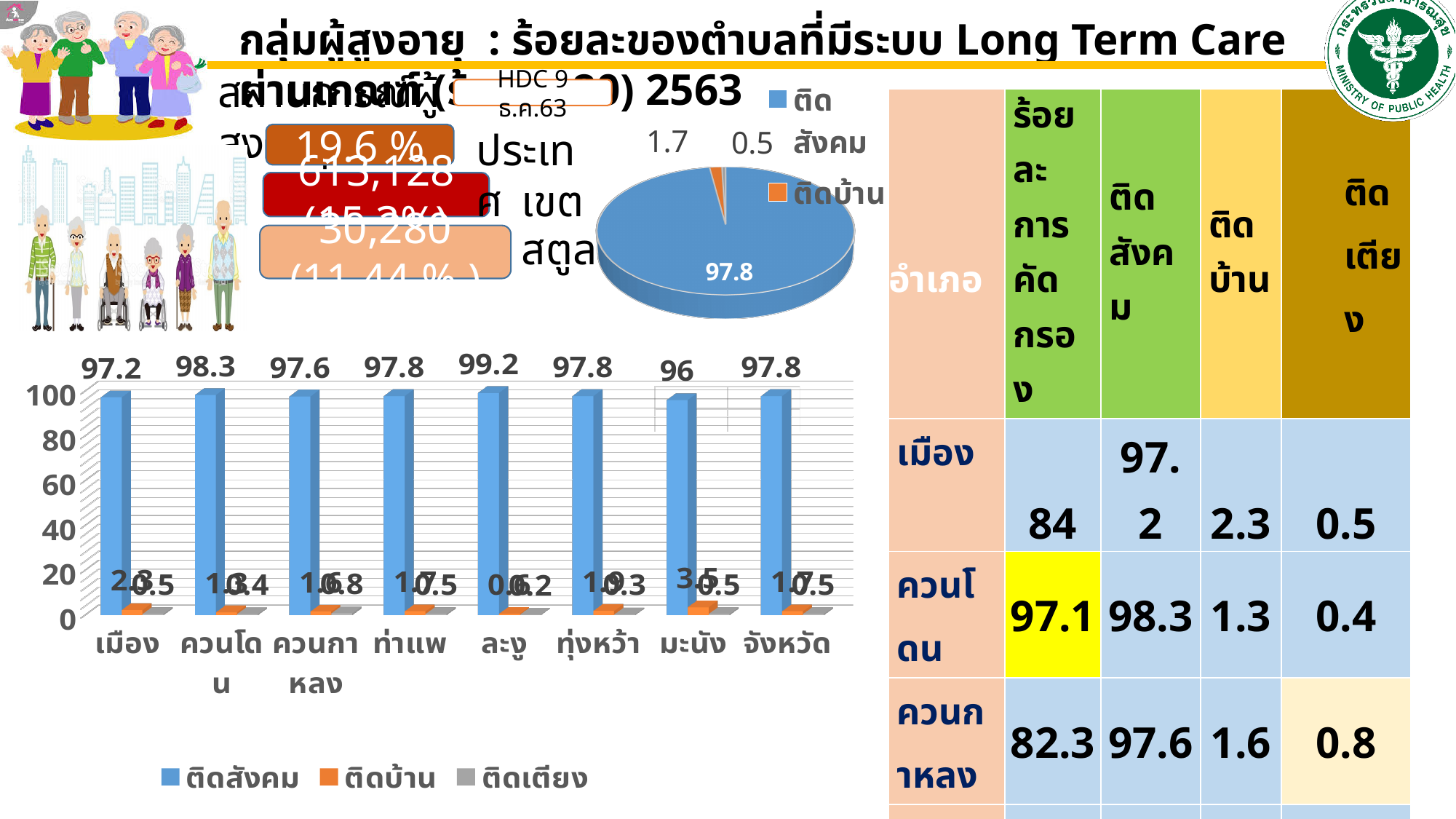
How many categories are shown on the x axis of the bar chart? 8 In the bar chart, what is the ติดสังคม value for มะนัง? 96 How many series does the legend of the bar chart list? 3 In the bar chart, what is the ติดสังคม value for ละงู? 99.2 In the pie chart, what is the value of the ติดสังคม slice? 97.8 What kind of chart is the chart at the bottom left of the slide? bar chart In the bar chart, which has the larger ติดสังคม value, ควนโดน or เมือง? ควนโดน In the bar chart, which category has the lowest ติดสังคม value? มะนัง In the bar chart, is the ติดสังคม value for เมือง greater or less than 80? greater In the bar chart, which category has the highest ติดสังคม value? ละงู In the bar chart, what is the difference between the ติดสังคม values for ละงู and มะนัง? 3.2 In the bar chart, what is the ติดสังคม value for จังหวัด? 97.8